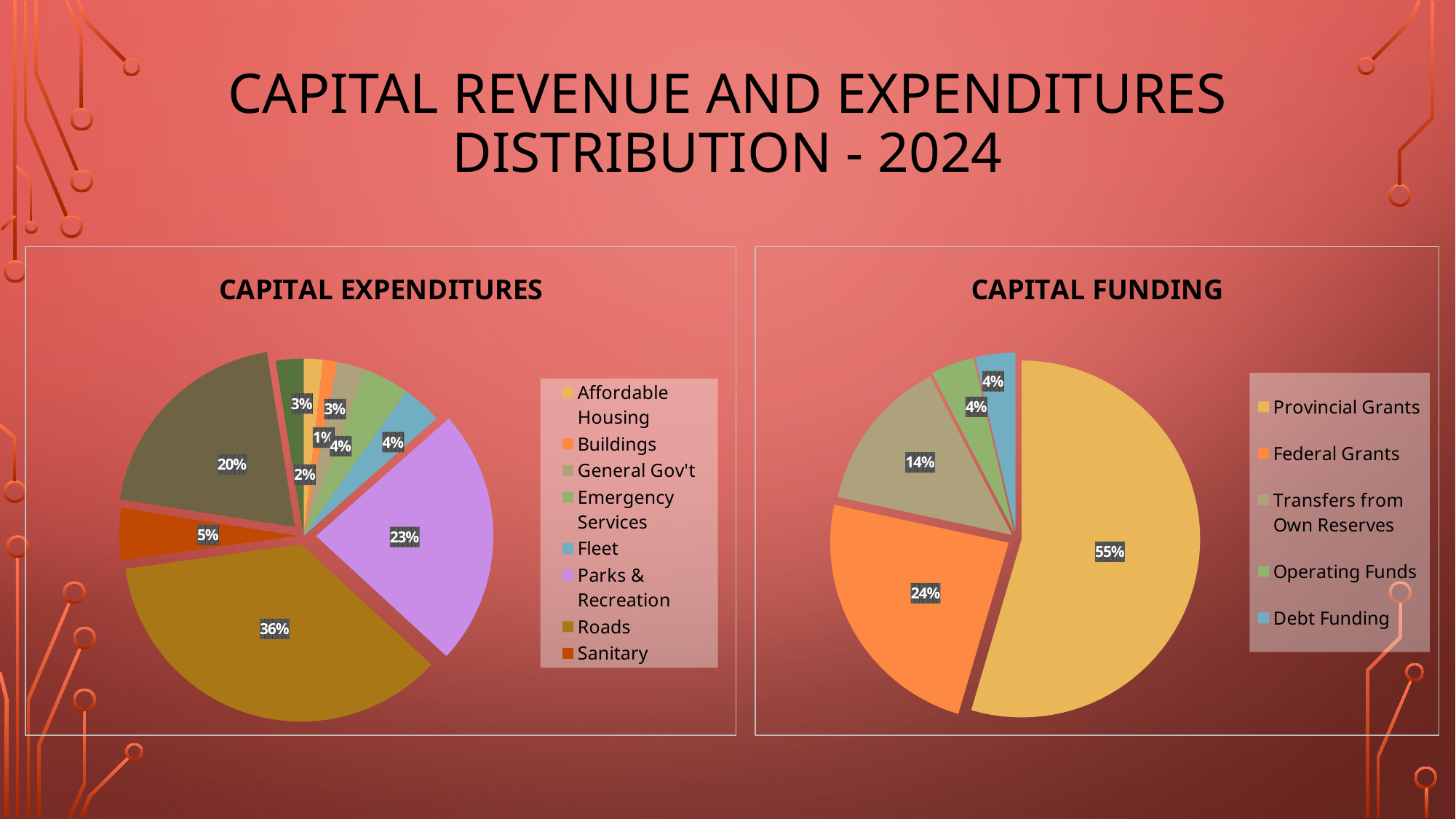
In the Capital Expenditures chart, which category has the largest share? Roads In the Capital Funding chart, what share is Provincial Grants? 55% In the Capital Funding chart, which funding source has the largest share? Provincial Grants How many categories does the Capital Funding pie chart show? 5 In the Capital Expenditures chart, which is larger: Roads or Parks & Recreation? Roads In the Capital Funding chart, how many percentage points larger is Provincial Grants than Federal Grants? 31 percentage points In the Capital Expenditures chart, what share is Roads? 36% In the Capital Expenditures chart, what share is Sanitary? 5% What kind of chart is the Capital Funding chart? pie chart